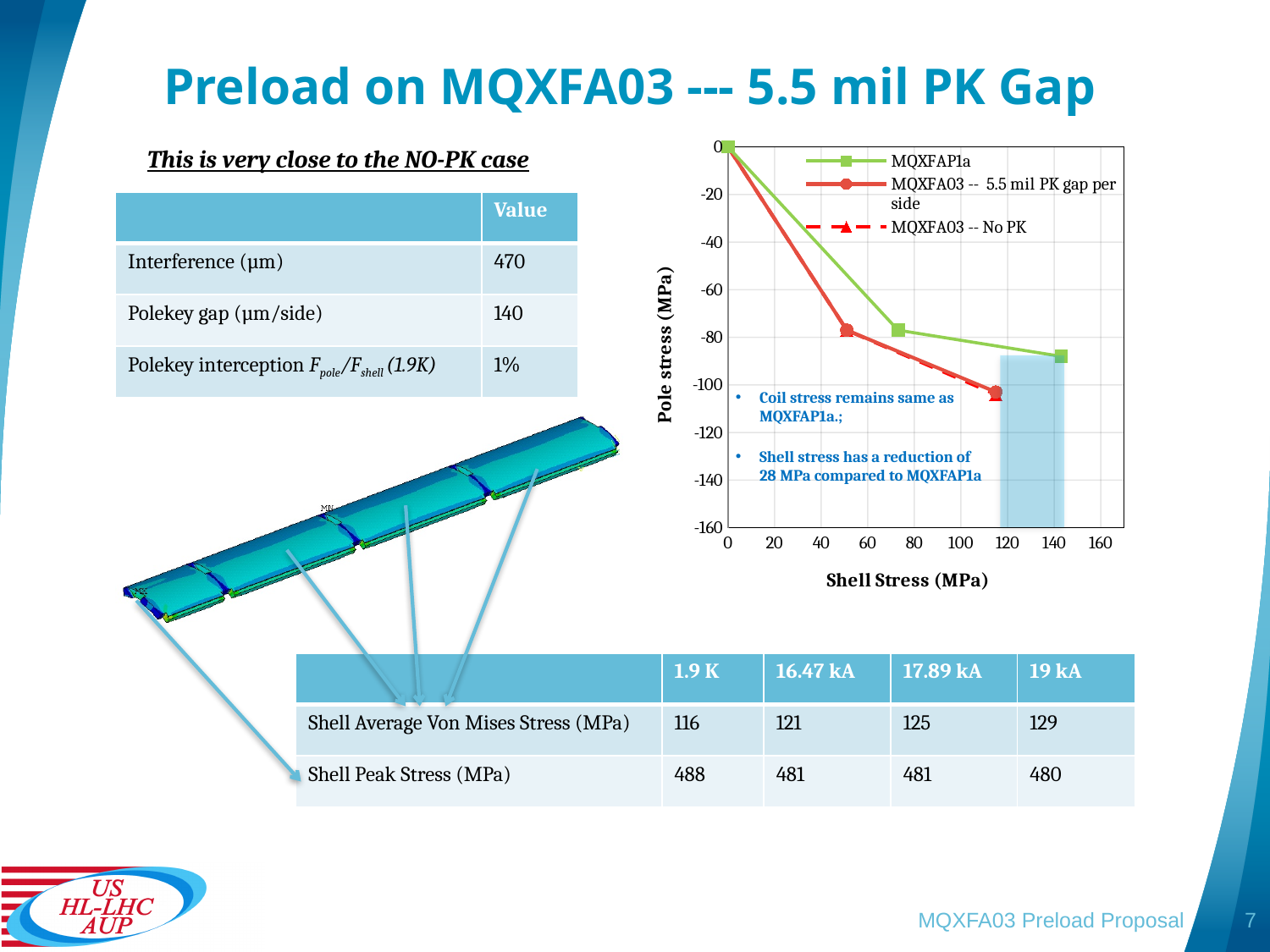
Is the shell stress at the final point of the MQXFA03 -- 5.5 mil PK gap per side series greater or less than 140? less Which series reaches the more negative pole stress at its final point, MQXFAP1a or MQXFA03 -- 5.5 mil PK gap per side? MQXFA03 -- 5.5 mil PK gap per side Is the pole stress at the final point of the MQXFAP1a series above or below -100 on the y axis? above Is the shell stress at the final point of the MQXFAP1a series greater or less than 120? greater What is the title of the x axis of the chart? Shell Stress (MPa) Which series reaches the higher shell stress at its final point, MQXFAP1a or MQXFA03 -- 5.5 mil PK gap per side? MQXFAP1a Which series in the chart is drawn with a dashed line? MQXFA03 -- No PK How many series does the chart legend list? 3 As shell stress increases along the x axis, does the pole stress for MQXFAP1a rise or fall? fall What kind of chart is shown on the slide? line chart